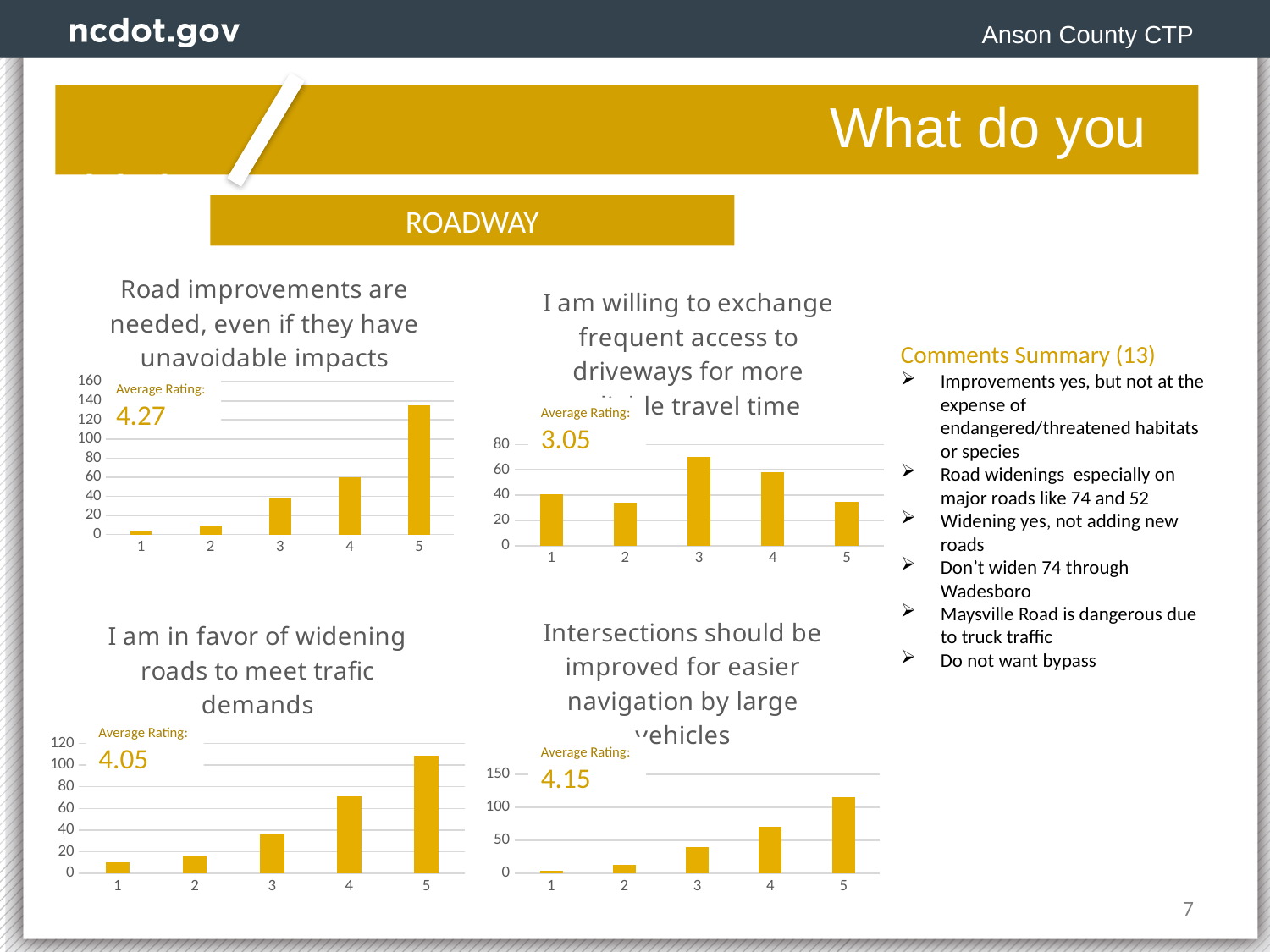
In the chart titled 'Road improvements are needed, even if they have unavoidable impacts', which rating category has the lowest bar? 1 In the chart titled 'I am in favor of widening roads to meet trafic demands', do the values rise or fall as the rating goes from 1 to 5? rise In the chart titled 'Road improvements are needed, even if they have unavoidable impacts', which rating category has the highest bar? 5 In the chart titled 'I am in favor of widening roads to meet trafic demands', is the value for rating 5 greater or less than 100? greater In the chart titled 'I am willing to exchange frequent access to driveways for more reliable travel time', is the value for rating 3 greater or less than 60? greater In the chart titled 'Intersections should be improved for easier navigation by large vehicles', which is larger, the value for rating 4 or rating 5? 5 In the chart titled 'I am willing to exchange frequent access to driveways for more reliable travel time', what average rating is printed on the chart? 3.05 In the chart titled 'I am willing to exchange frequent access to driveways for more reliable travel time', which rating category has the highest bar? 3 In the chart titled 'Road improvements are needed, even if they have unavoidable impacts', what kind of chart is shown? bar chart In the chart titled 'Road improvements are needed, even if they have unavoidable impacts', is the value for rating 5 greater or less than 120? greater In the chart titled 'Road improvements are needed, even if they have unavoidable impacts', what average rating is printed on the chart? 4.27 In the chart titled 'Road improvements are needed, even if they have unavoidable impacts', how many rating categories are shown on the x axis? 5